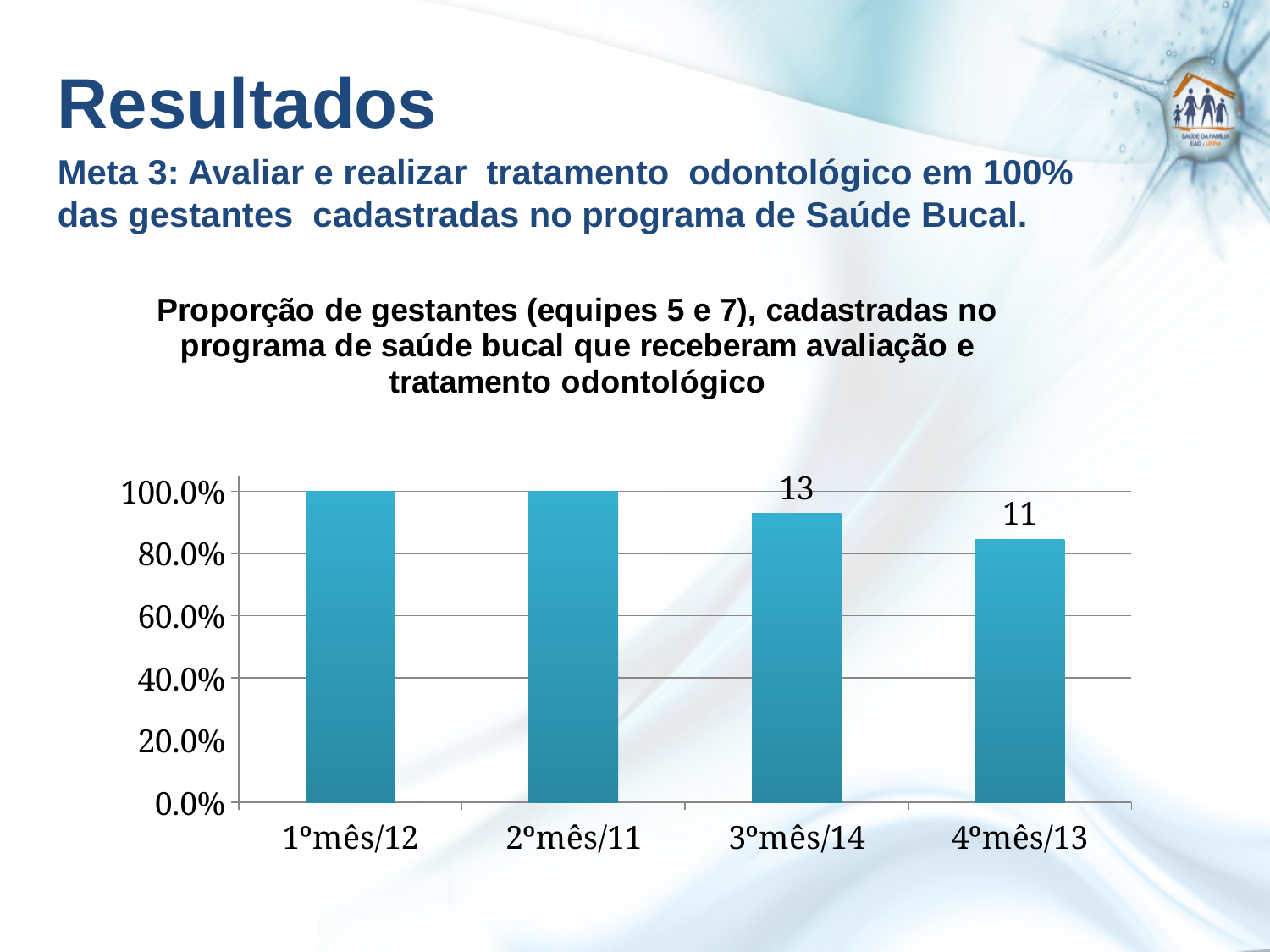
What is the value for 1ºmês/12? 100.0% What is the value for 2ºmês/11? 100.0% Is the value for 4ºmês/13 greater or less than 100.0%? less What data label is printed above the bar for 3ºmês/14? 13 Which category has the lowest bar? 4ºmês/13 Which bar is taller, 3ºmês/14 or 4ºmês/13? 3ºmês/14 What kind of chart is shown on the slide? bar chart Is the value for 3ºmês/14 greater or less than 80.0%? greater What is the first word of the chart title? Proporção How many categories are shown on the x axis of the chart? 4 What data label is printed above the bar for 4ºmês/13? 11 Do the bar values rise or fall from 2ºmês/11 to 4ºmês/13? fall